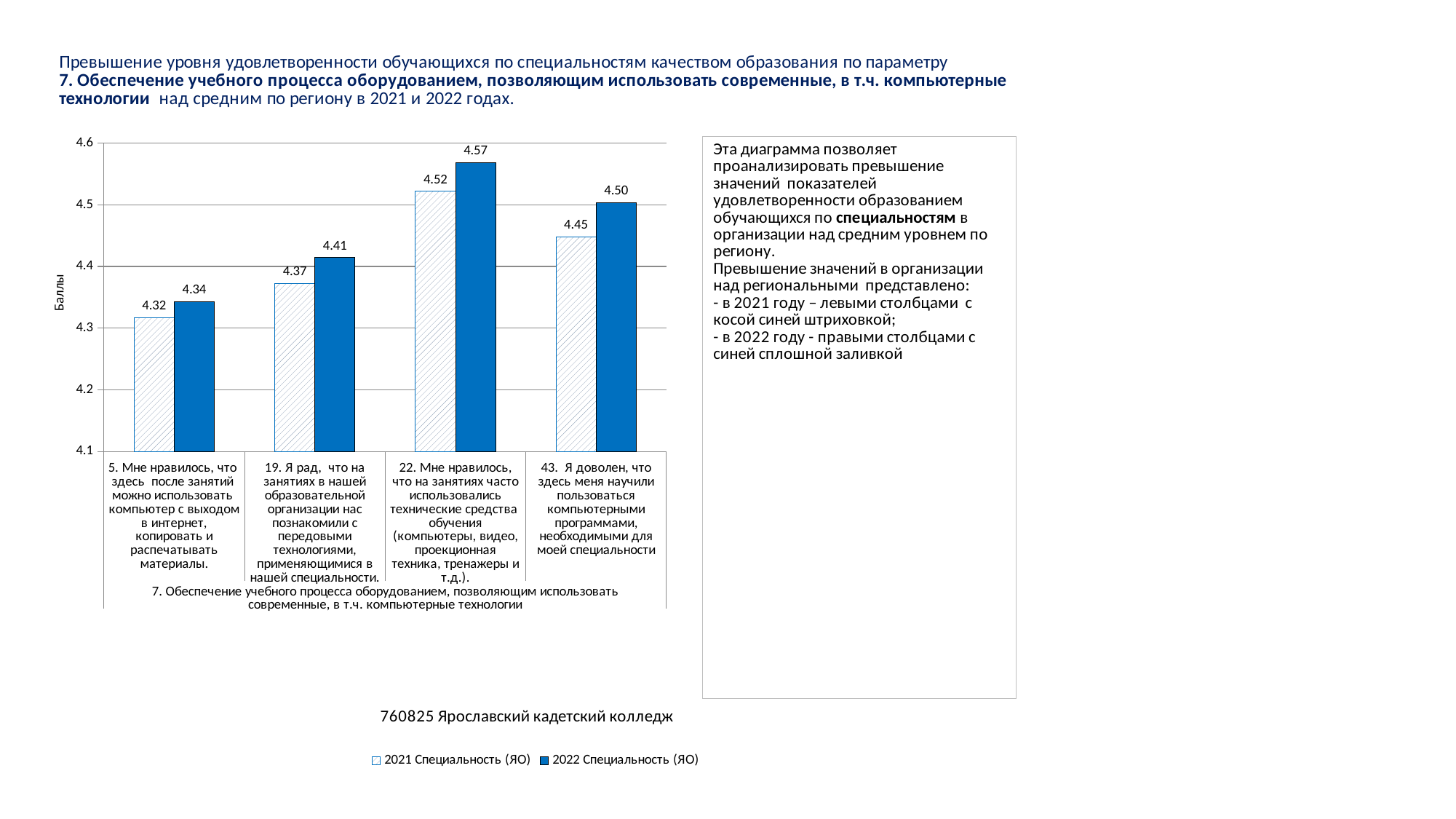
What kind of chart is shown on the slide? Bar chart Which category has the lowest value in the 2021 Специальность (ЯО) series? 5. Мне нравилось, что здесь после занятий можно использовать компьютер с выходом в интернет What is the value for the 2022 Специальность (ЯО) series for category 22 (Мне нравилось, что на занятиях часто использовались технические средства обучения)? 4.57 What is the label of the y axis of the chart? Баллы What is the difference between the 2022 and 2021 values for category 43 (Я доволен, что здесь меня научили пользоваться компьютерными программами)? 0.05 Is the 2022 Специальность (ЯО) value for category 22 greater or less than 4.5? greater How many series does the legend list? 2 What is the value for the 2021 Специальность (ЯО) series for category 43 (Я доволен, что здесь меня научили пользоваться компьютерными программами)? 4.45 Which category has the highest value in the 2022 Специальность (ЯО) series? 22. Мне нравилось, что на занятиях часто использовались технические средства обучения How many categories are shown on the x axis of the chart? 4 What is the value for the 2021 Специальность (ЯО) series for category 5 (Мне нравилось, что здесь после занятий можно использовать компьютер с выходом в интернет)? 4.32 Which is larger for category 19 (Я рад, что на занятиях в нашей образовательной организации нас познакомили с передовыми технологиями): the 2021 value or the 2022 value? 2022 value (4.41)